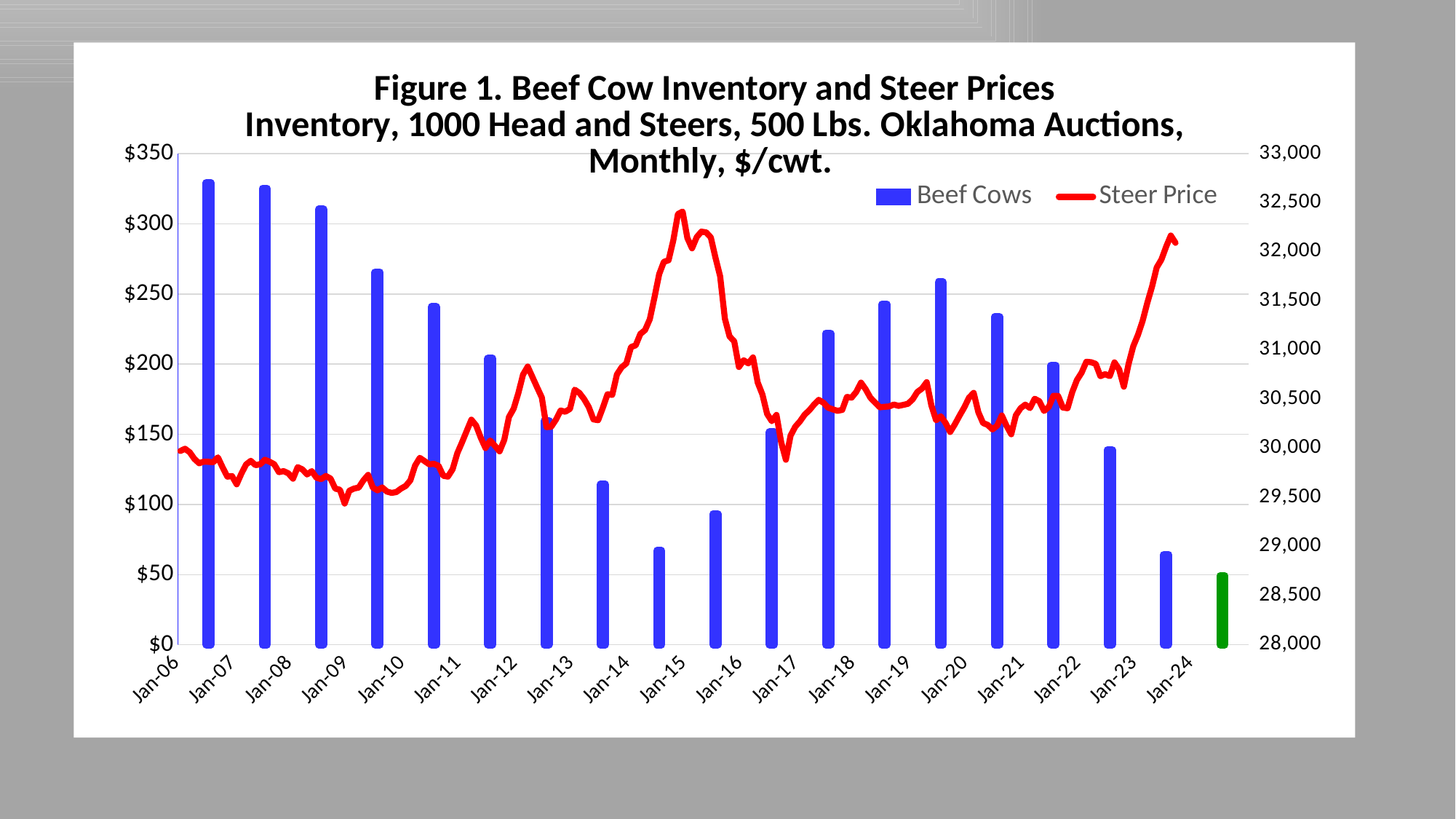
Does the Steer Price line rise or fall from Jan-22 to Jan-24? Rise Is the Beef Cows bar for Jan-07 greater or less than 32,500 on the right-hand axis? greater What colour is the Steer Price line? Red What kind of chart is shown on the slide? A combination bar and line chart How many year labels are shown along the x axis, from Jan-06 to Jan-24? 19 Is the Beef Cows bar for Jan-09 taller or shorter than the bar for Jan-10? Taller Do the Beef Cows bars rise or fall from Jan-07 to Jan-15? Fall What are the two series named in the legend? Beef Cows and Steer Price Is the Beef Cows bar for Jan-19 taller or shorter than the bar for Jan-18? Taller How many series does the legend list? 2 Is the Beef Cows bar for Jan-13 taller or shorter than the bar for Jan-14? Taller